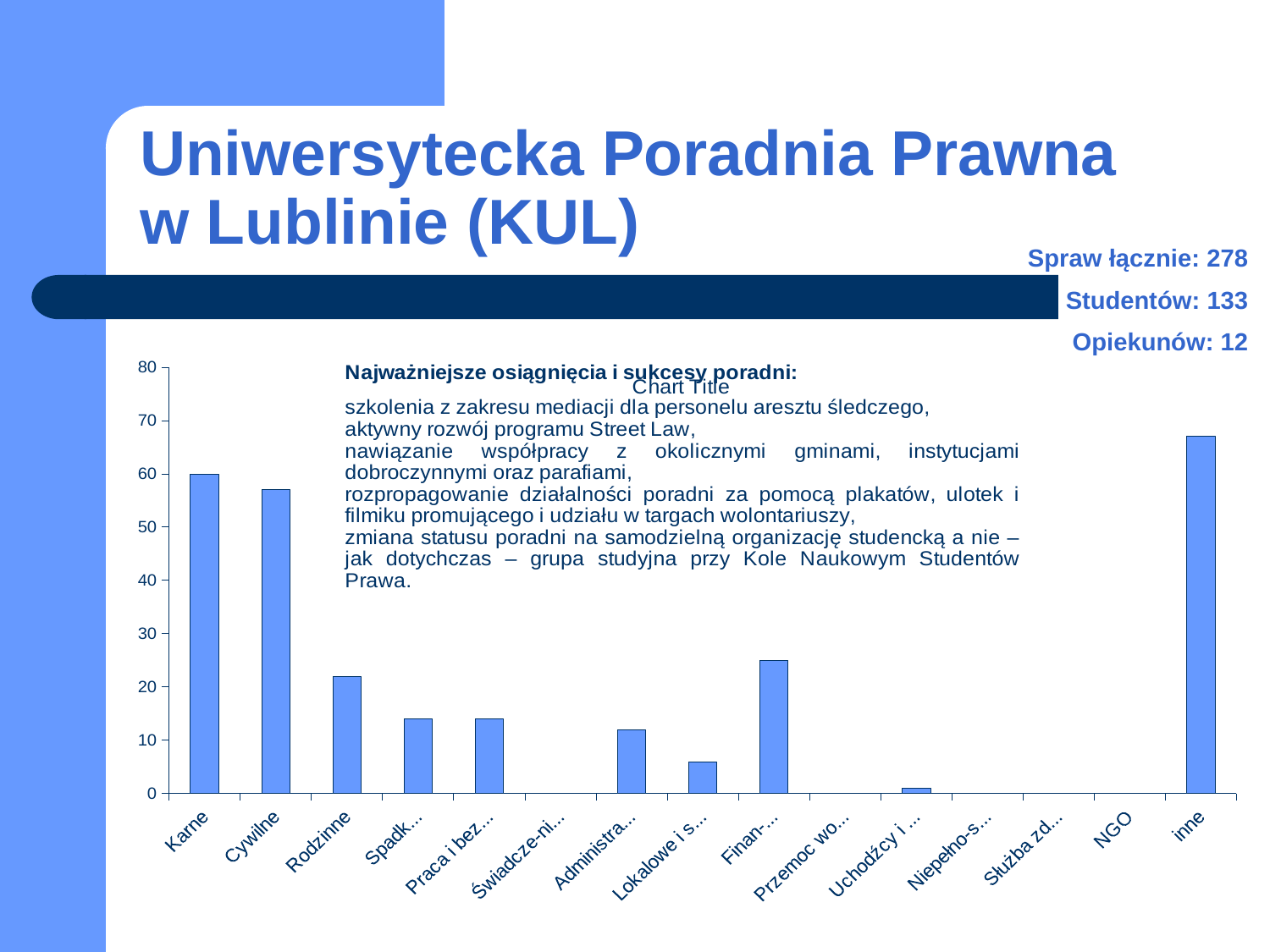
Is the value for Lokalowe i s... greater or less than 10? less Which is larger, the value for Karne or the value for Rodzinne? Karne Is the value for Cywilne greater or less than 50? greater Which is larger, the value for inne or the value for Cywilne? inne How many categories are shown on the x axis of the chart? 15 Is the value for Rodzinne greater or less than 30? less What is the value for Karne in the chart? 60 What kind of chart is shown on the slide? bar chart What is the title shown on the chart? Chart Title Which category has the highest bar in the chart? inne